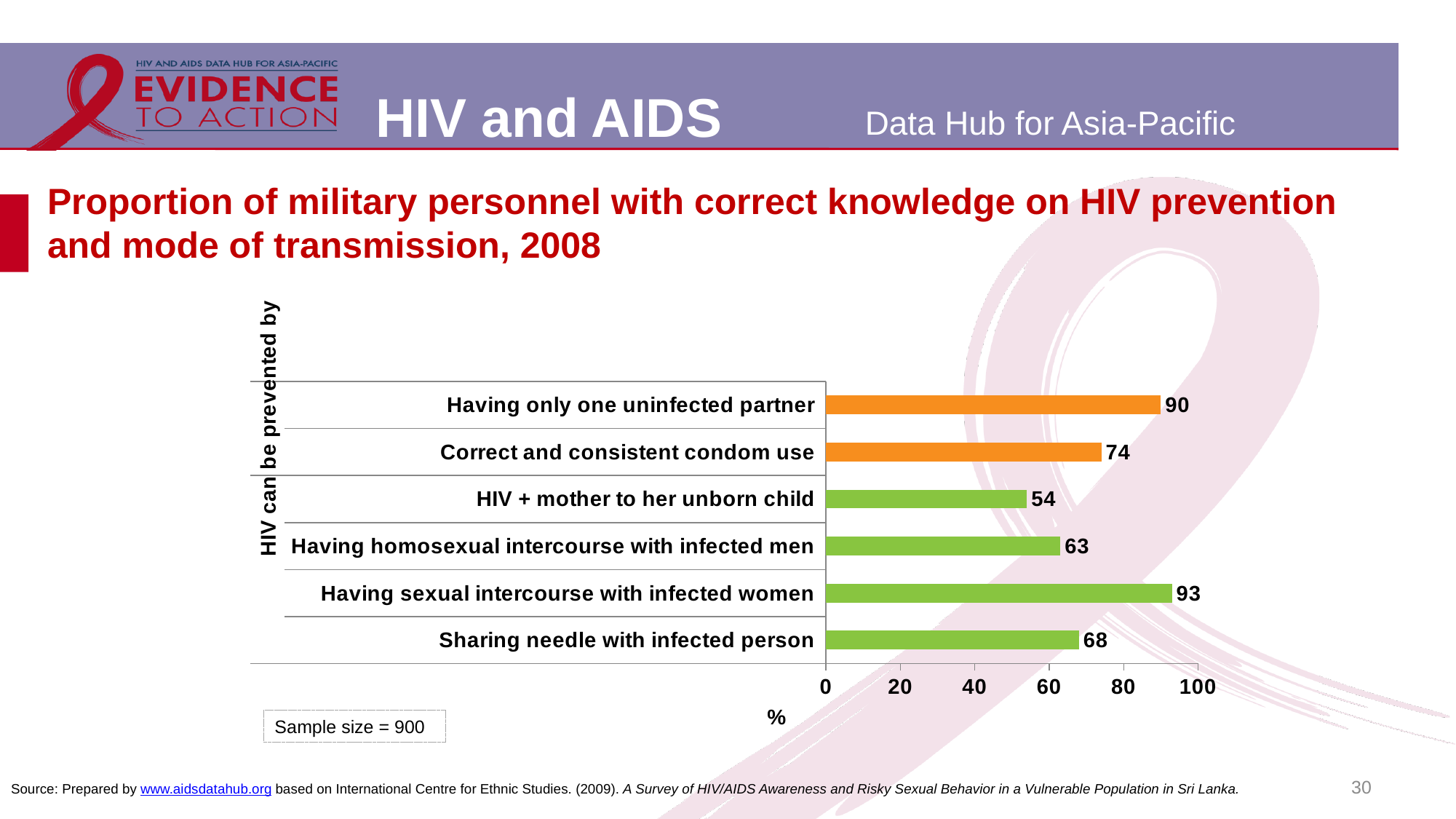
What is the sample size stated on the slide? 900 Which category has the highest value? Having sexual intercourse with infected women What is the difference between the values for 'Having only one uninfected partner' and 'Correct and consistent condom use'? 16 What is the value for 'Correct and consistent condom use'? 74 What is the value for 'Having only one uninfected partner'? 90 What is the value for 'Sharing needle with infected person'? 68 Which is larger: the value for 'Having homosexual intercourse with infected men' or 'Sharing needle with infected person'? Sharing needle with infected person Is the value for 'Having sexual intercourse with infected women' greater or less than 80? greater What kind of chart is shown on the slide? bar chart Which category has the lowest value? HIV + mother to her unborn child What is the value for 'HIV + mother to her unborn child'? 54 How many categories are shown in the chart? 6